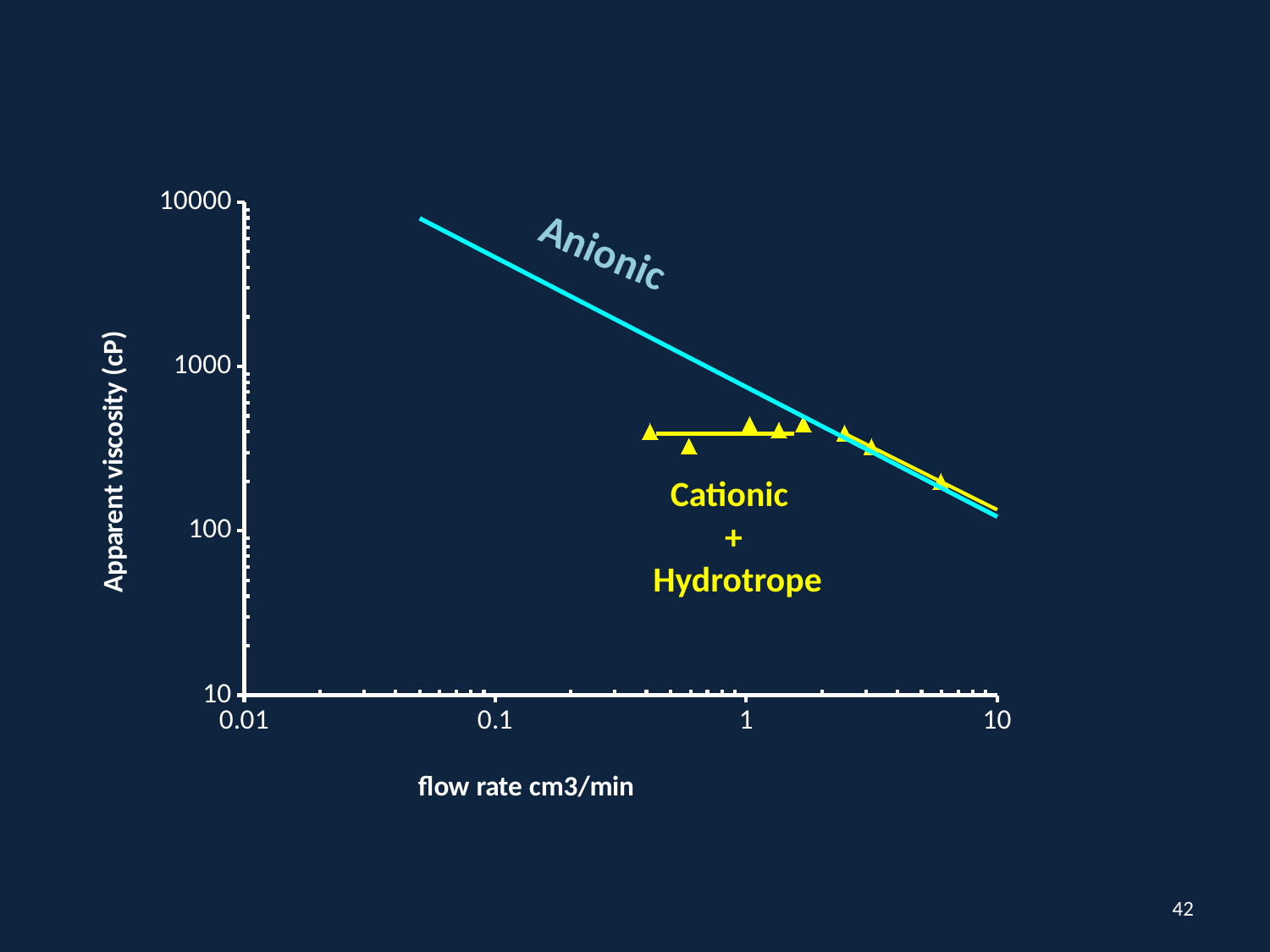
Is the apparent viscosity of the Cationic + Hydrotrope series at a flow rate of 1 greater or less than 1000? less At a flow rate of 1, which series has the higher apparent viscosity, Anionic or Cationic + Hydrotrope? Anionic How many series are plotted on the chart? 2 Which series is drawn with triangle markers? Cationic + Hydrotrope Does the Anionic line rise or fall as flow rate increases? fall What is the label of the x axis? flow rate cm3/min Is the apparent viscosity of the Anionic series at a flow rate of 0.1 greater or less than 1000? greater Is the apparent viscosity of the Cationic + Hydrotrope series at a flow rate of 1 greater or less than 100? greater What kind of chart is shown on the slide? line chart What is the label of the y axis? Apparent viscosity (cP)